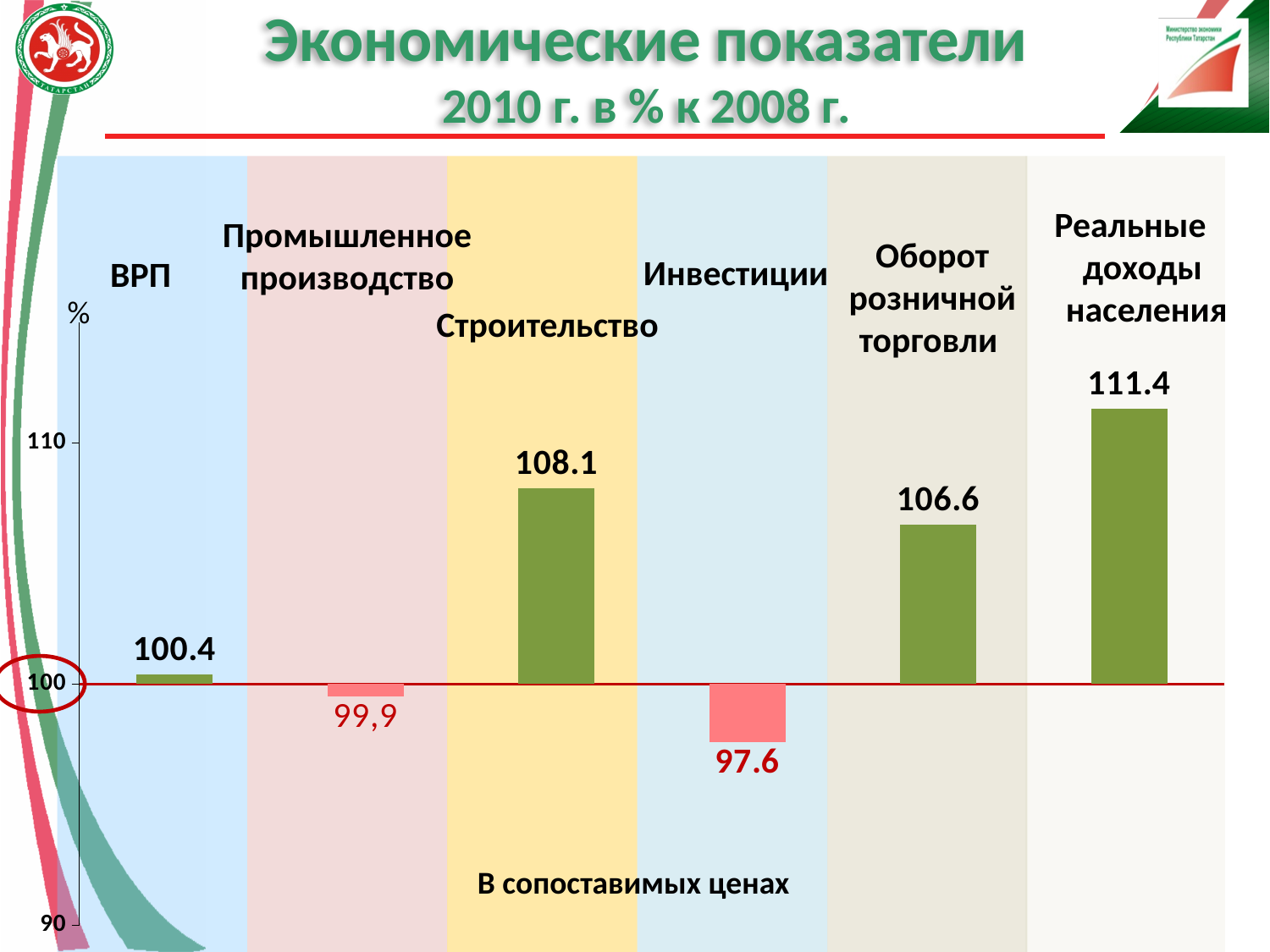
Which is larger, the value for Строительство or the value for Оборот розничной торговли? Строительство Is the value for ВРП greater or less than 110? less What is the value for Промышленное производство? 99,9 What is the value for Строительство? 108.1 Which category has the lowest value? Инвестиции What kind of chart is shown on the slide? bar chart Which category has the highest value? Реальные доходы населения What is the value for Инвестиции? 97.6 What is the title of the chart on the slide? Экономические показатели 2010 г. в % к 2008 г. What is the difference between the values for Реальные доходы населения and Оборот розничной торговли? 4.8 What is the value for Реальные доходы населения? 111.4 How many categories are shown in the chart? 6